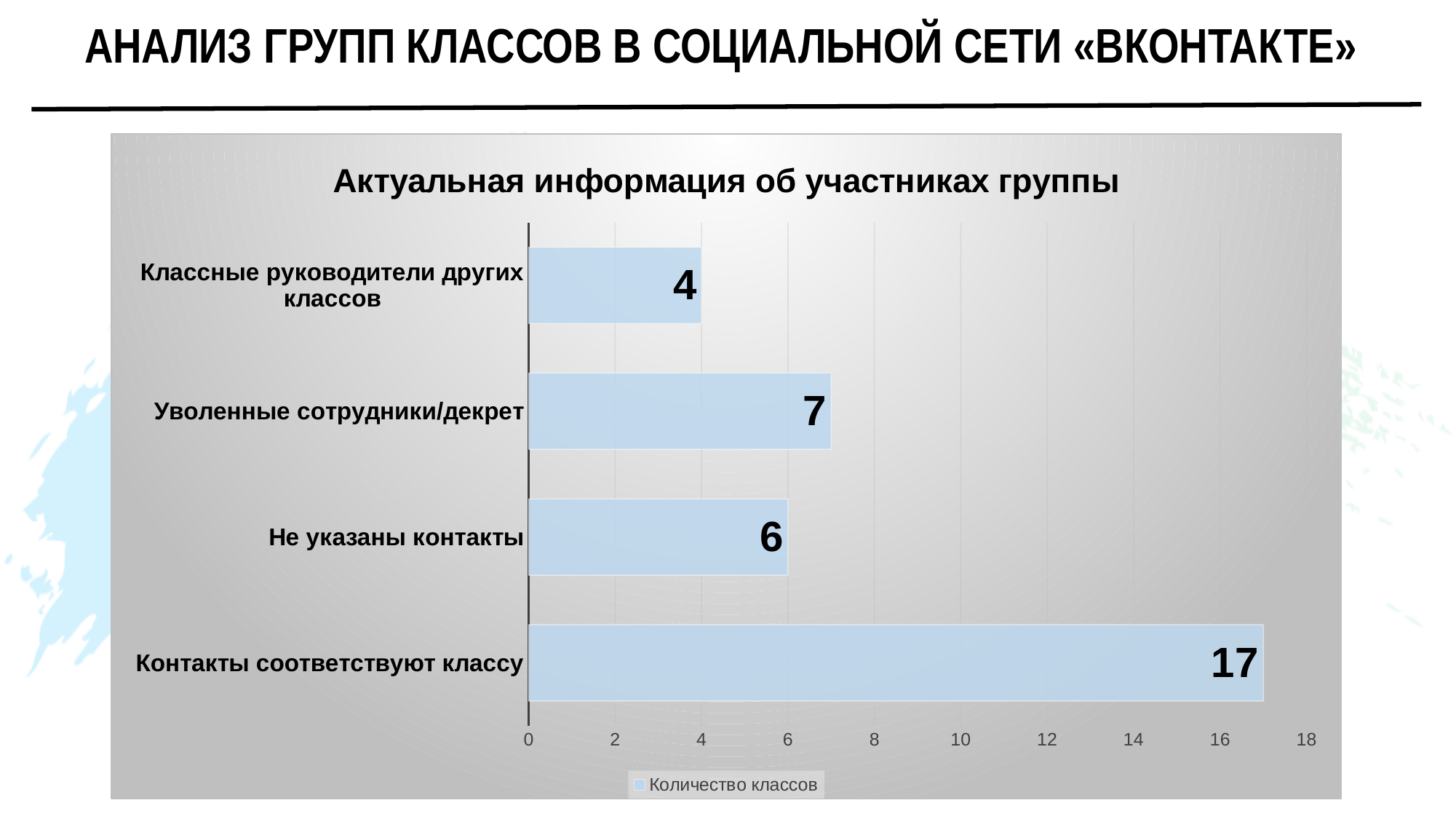
Which category has the lowest value? Классные руководители других классов Which category has the highest value? Контакты соответствуют классу How many categories are shown in the chart? 4 Which is larger: the value for "Уволенные сотрудники/декрет" or for "Не указаны контакты"? Уволенные сотрудники/декрет What is the difference between the values for "Контакты соответствуют классу" and "Уволенные сотрудники/декрет"? 10 What is the value for "Не указаны контакты"? 6 Is the value for "Контакты соответствуют классу" greater or less than 10? greater What is the title of the chart? Актуальная информация об участниках группы What is the value for "Классные руководители других классов"? 4 What kind of chart is shown on the slide? bar chart What is the value for "Контакты соответствуют классу"? 17 What is the value for "Уволенные сотрудники/декрет"? 7